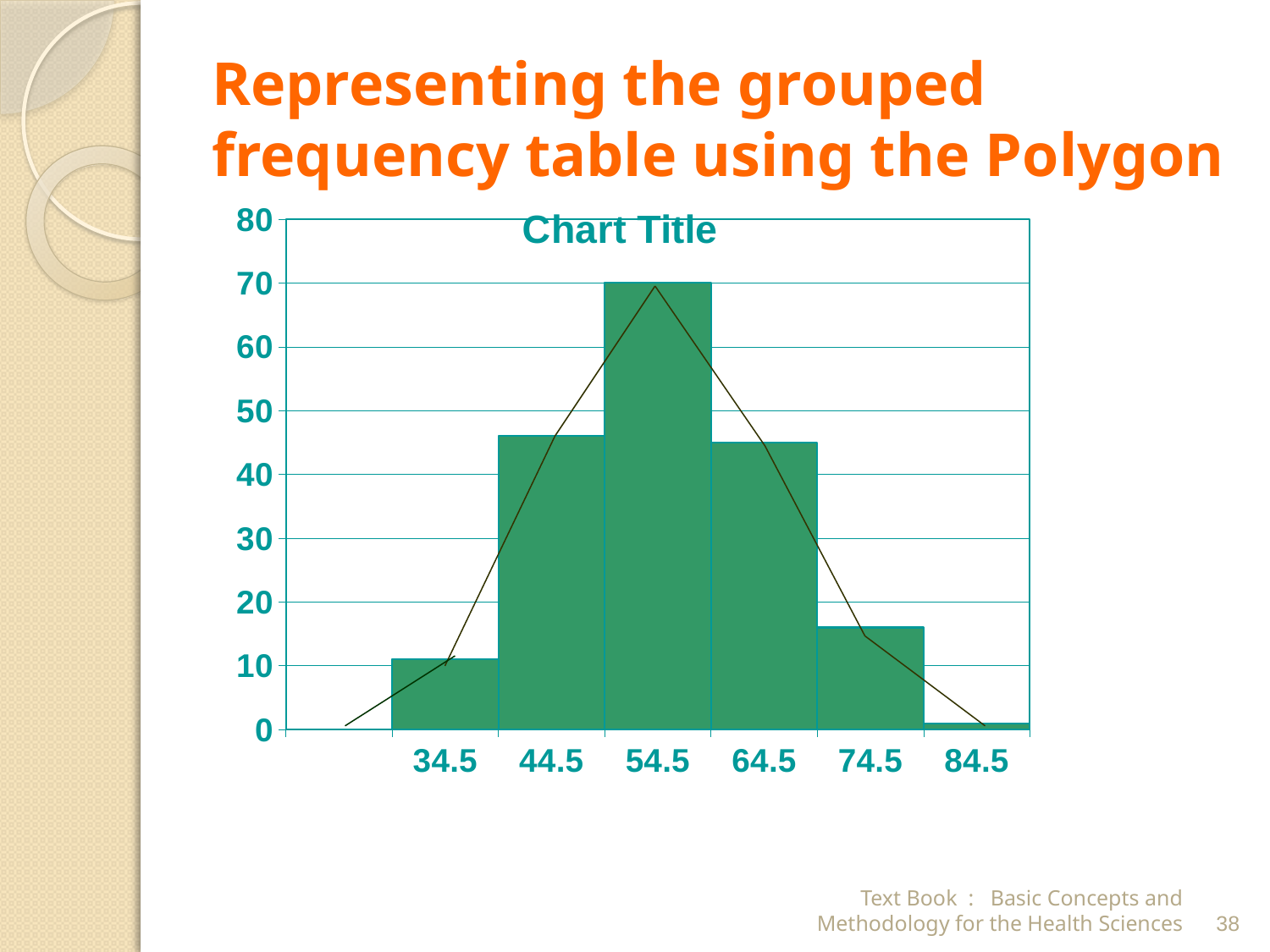
What kind of chart is shown on the slide? bar chart Is the value for 44.5 greater or less than 40? greater What is the title shown on the chart? Chart Title Is the value for 74.5 greater or less than 20? less Is the value for 64.5 greater or less than 50? less Which is larger, the value for 44.5 or the value for 74.5? 44.5 What colour are the bars in the chart? green Which category has the lowest bar? 84.5 Which category has the highest bar? 54.5 What is the value of the bar for 54.5? 70 How many categories are shown on the x axis of the chart? 6